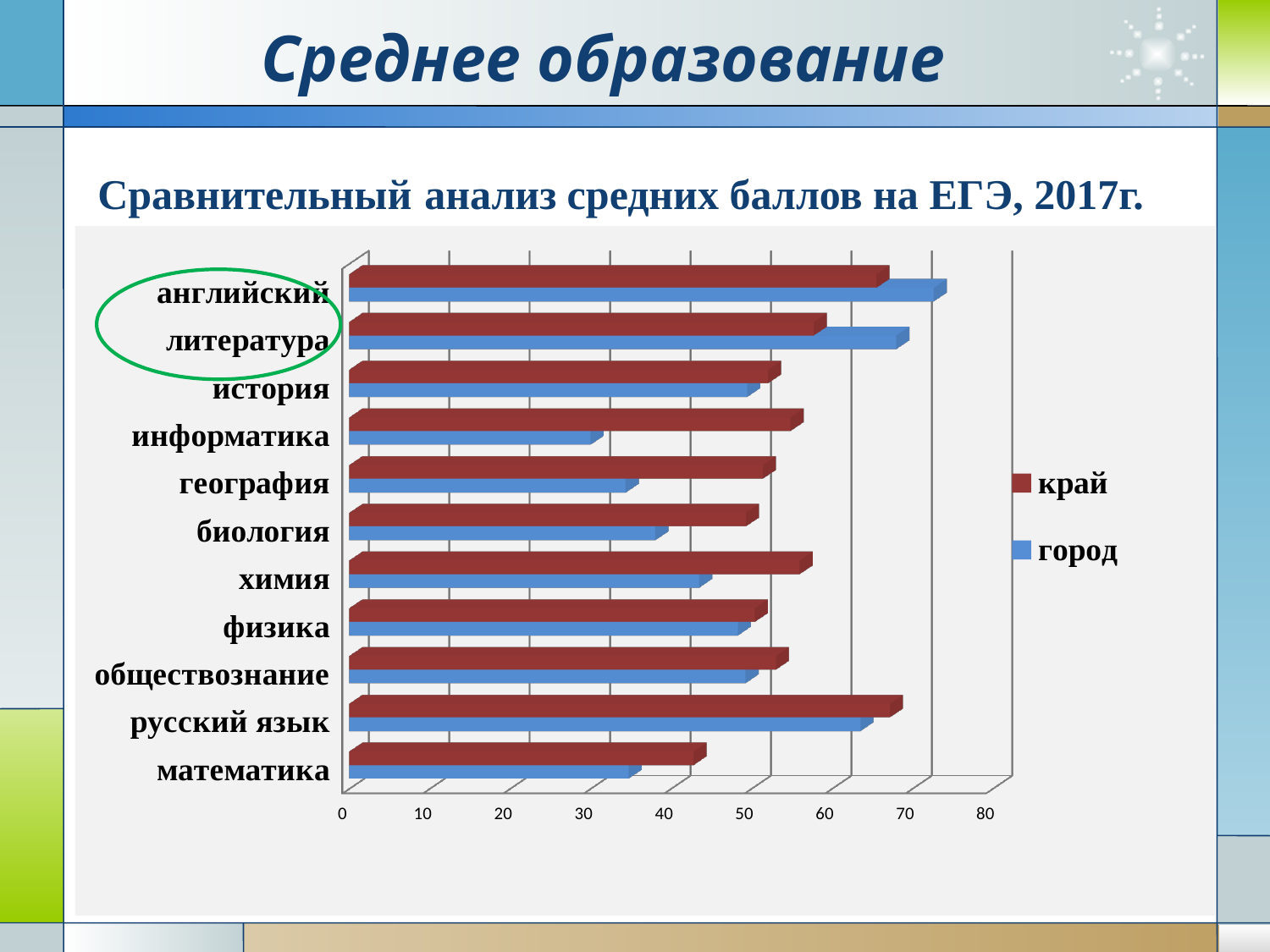
How many subjects (categories) are shown on the chart? 11 What kind of chart is shown on the slide? bar chart Is the город value for математика greater or less than 40? less For информатика, which is larger: край or город? край Which subject has the lowest value for the город series? информатика Which subject has the highest value for the город series? английский Which subject has the lowest value for the край series? математика What is the title of the chart? Сравнительный анализ средних баллов на ЕГЭ, 2017г. For английский, which is larger: край or город? город How many series does the legend list? 2 Is the край value for русский язык greater or less than 60? greater Is the город value for английский greater or less than 70? greater